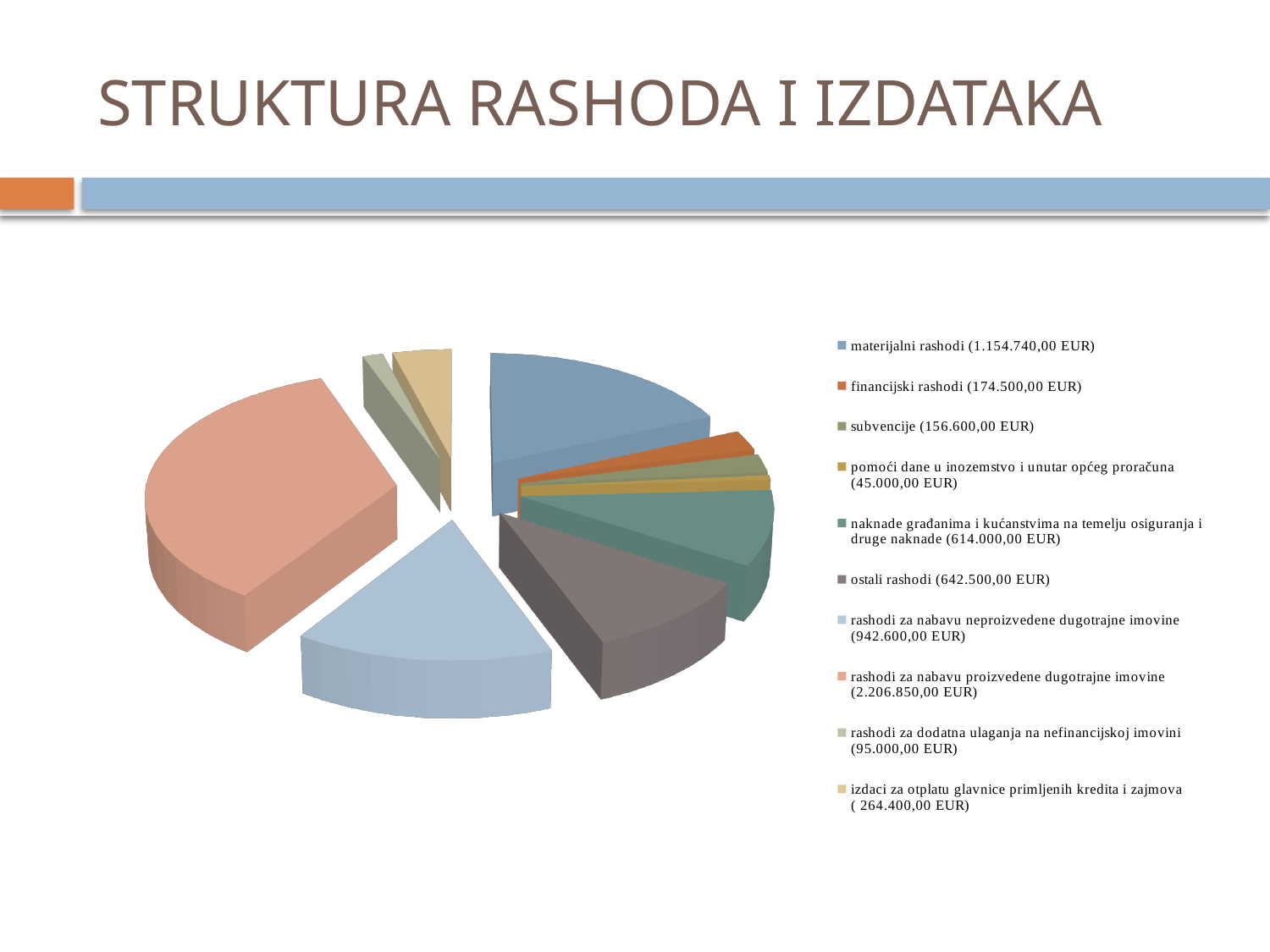
How many categories does the pie chart show? 10 What kind of chart is shown on the slide? Pie chart What is the value for rashodi za nabavu neproizvedene dugotrajne imovine? 942.600,00 EUR What is the value for materijalni rashodi? 1.154.740,00 EUR Which category has the largest value? rashodi za nabavu proizvedene dugotrajne imovine Which category has the smallest value? pomoći dane u inozemstvo i unutar općeg proračuna What is the value for izdaci za otplatu glavnice primljenih kredita i zajmova? 264.400,00 EUR What is the value for financijski rashodi? 174.500,00 EUR What is the value for subvencije? 156.600,00 EUR What is the title of the slide containing the pie chart? STRUKTURA RASHODA I IZDATAKA What is the difference between materijalni rashodi and financijski rashodi? 980.240,00 EUR Which is larger, ostali rashodi or naknade građanima i kućanstvima na temelju osiguranja i druge naknade? ostali rashodi